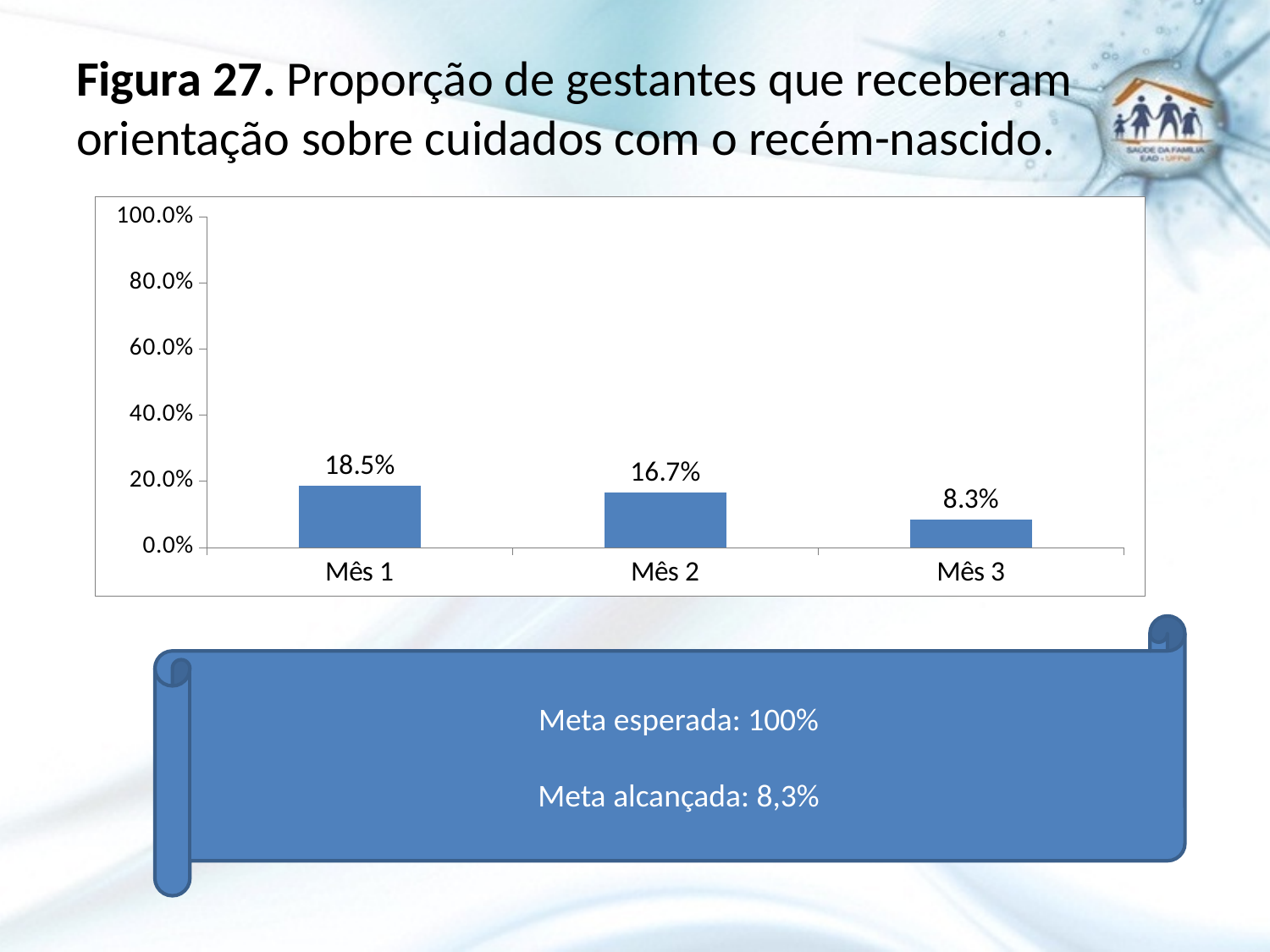
Which month has the highest value? Mês 1 How many months are shown on the x axis? 3 What is the difference between the values for Mês 1 and Mês 2? 1.8% Which month has the lowest value? Mês 3 What is the value for Mês 2? 16.7% What is the value for Mês 1? 18.5% Is the value for Mês 1 greater or less than 20.0%? less Which is larger, the value for Mês 2 or the value for Mês 3? Mês 2 Do the values rise or fall from Mês 1 to Mês 3? fall What kind of chart is shown on the slide? bar chart What is the value for Mês 3? 8.3% What is the difference between the values for Mês 1 and Mês 3? 10.2%